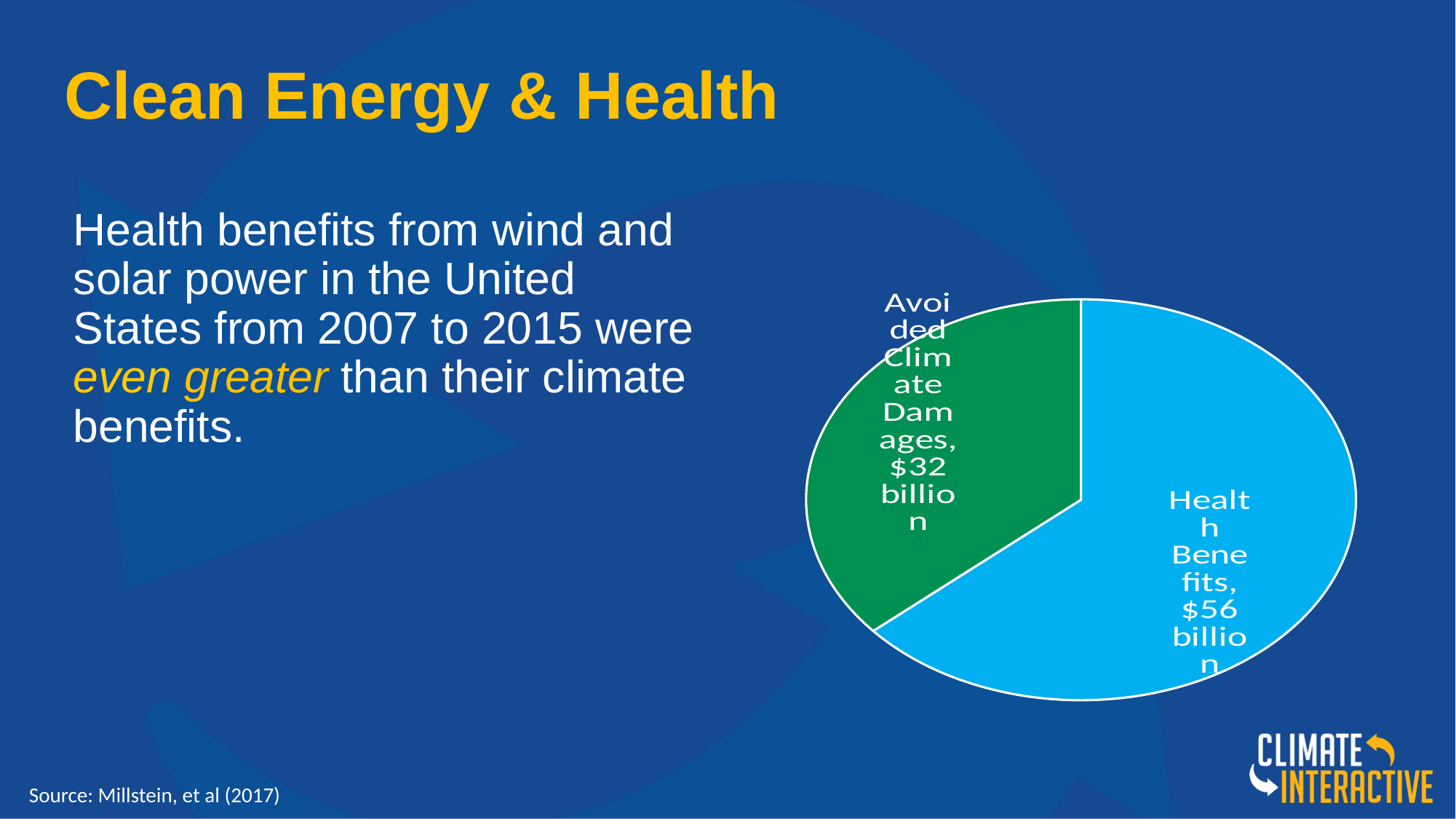
What is the value of the Avoided Climate Damages slice? $32 billion Which slice of the pie chart is the smallest? Avoided Climate Damages What share of the pie does the Health Benefits slice represent? 63.6% How many slices does the pie chart have? 2 How much larger are Health Benefits than Avoided Climate Damages? $24 billion What colour is the Avoided Climate Damages slice? green Which is larger, Health Benefits or Avoided Climate Damages? Health Benefits What is the combined total of the two slices in the pie chart? $88 billion What colour is the Health Benefits slice? light blue What kind of chart is shown on the slide? pie chart Which slice of the pie chart is the largest? Health Benefits What is the value of the Health Benefits slice? $56 billion